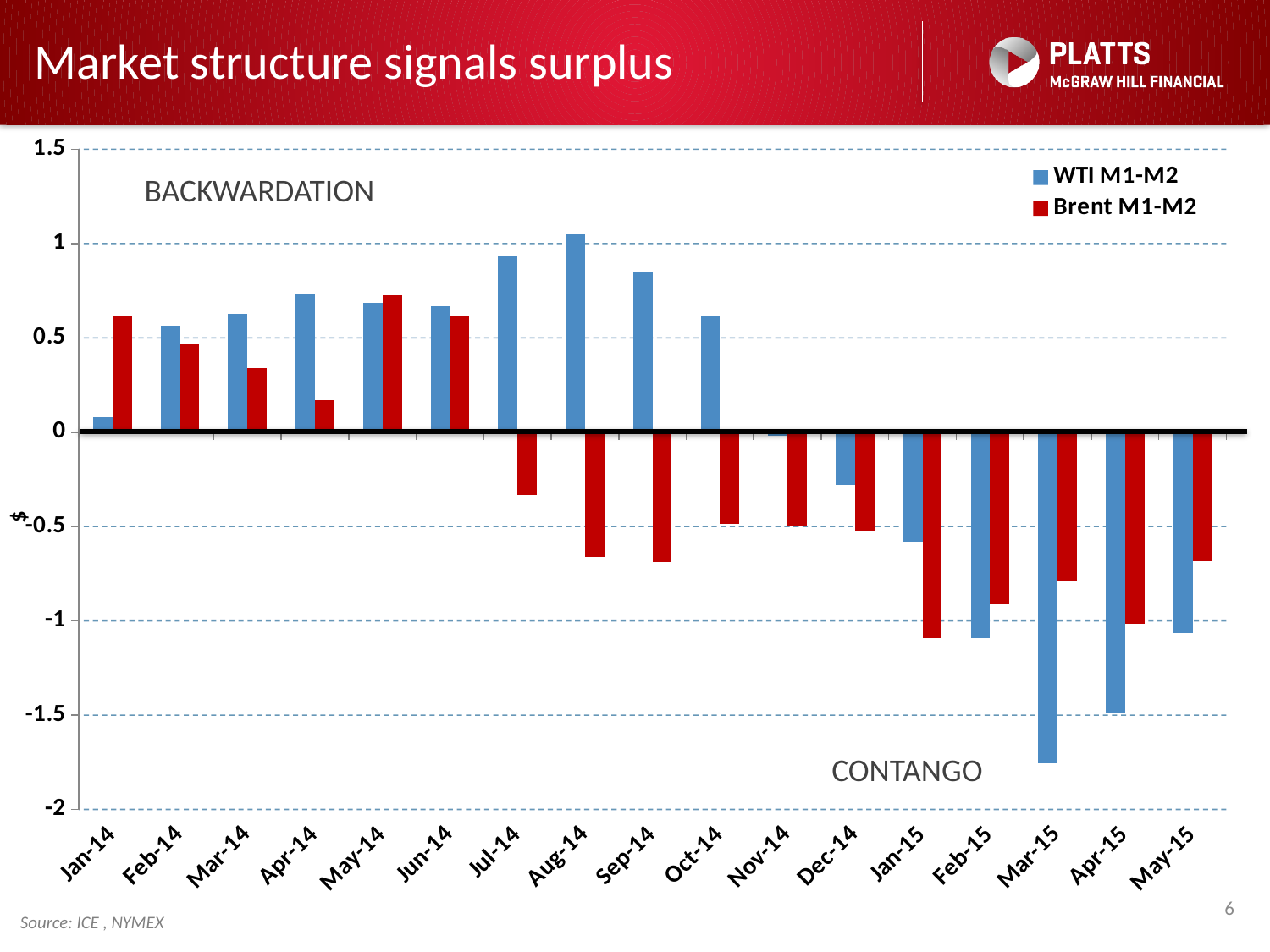
In Jan-14, which is larger: WTI M1-M2 or Brent M1-M2? Brent M1-M2 How many months are shown on the x axis? 17 What colour are the Brent M1-M2 bars? Red How many series does the legend list? 2 Is the WTI M1-M2 value for Aug-14 greater or less than 1? greater In which month is the WTI M1-M2 value lowest? Mar-15 Is the Brent M1-M2 value for Jul-14 greater or less than -0.5? greater In which month is the WTI M1-M2 value highest? Aug-14 Is the WTI M1-M2 value for Mar-15 greater or less than -1.5? less In which month is the Brent M1-M2 value highest? May-14 What kind of chart is shown on the slide? Bar chart Does the WTI M1-M2 value rise or fall from Oct-14 to Mar-15? Fall